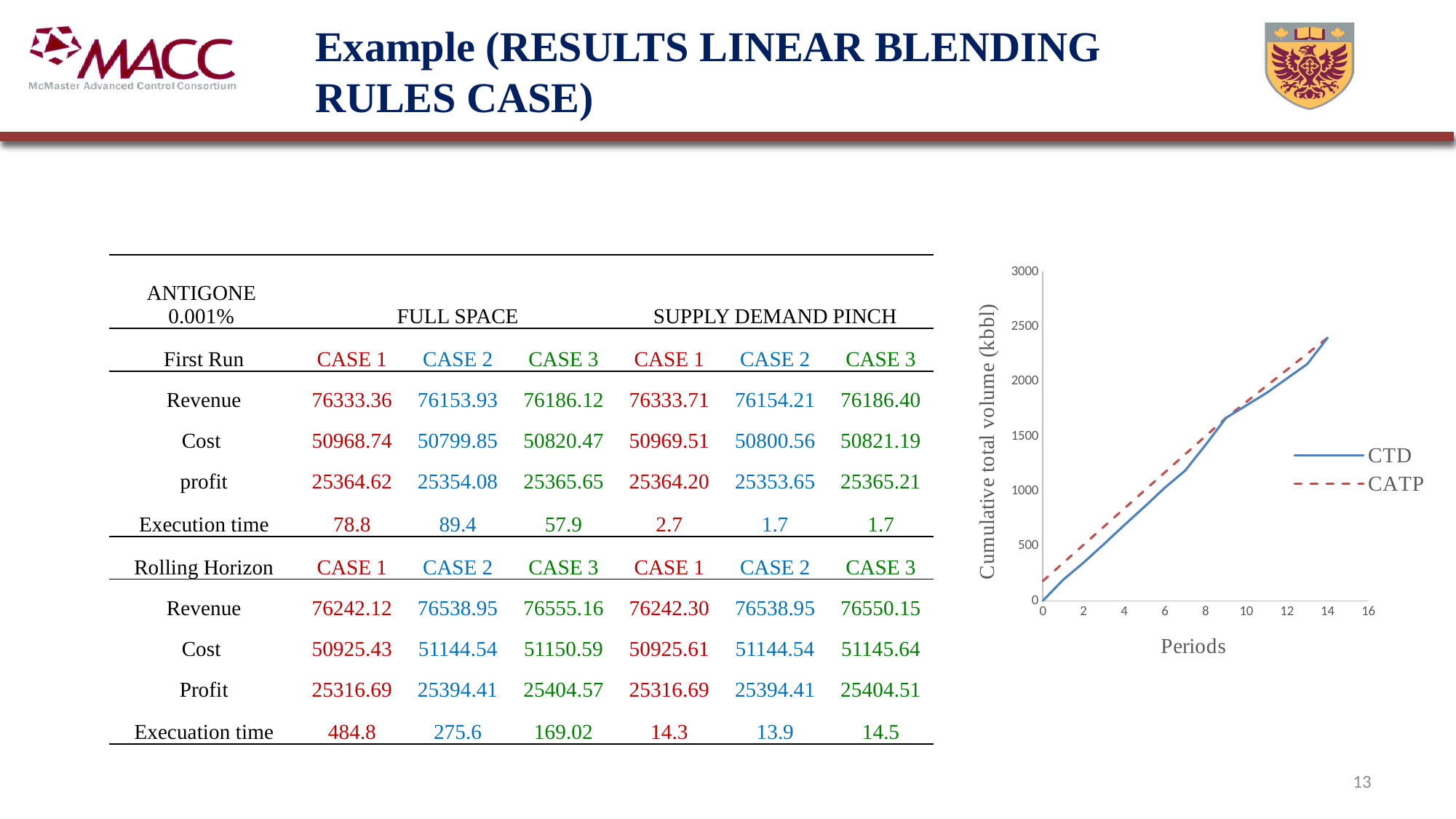
How many series does the legend of the line chart list? 2 Do the CATP values rise or fall as the period increases along the x axis? rise At period 4, which series has the larger value, CTD or CATP? CATP What kind of chart is shown on the right of the slide? line chart Is the CTD value at period 8 greater or less than 1000? greater Is the CTD value at period 14 greater or less than 2000? greater Is the CATP value at period 0 greater or less than 500? less What is the label of the x axis of the line chart? Periods Which series are listed in the legend of the line chart? CTD and CATP Do the CTD values rise or fall as the period increases along the x axis? rise